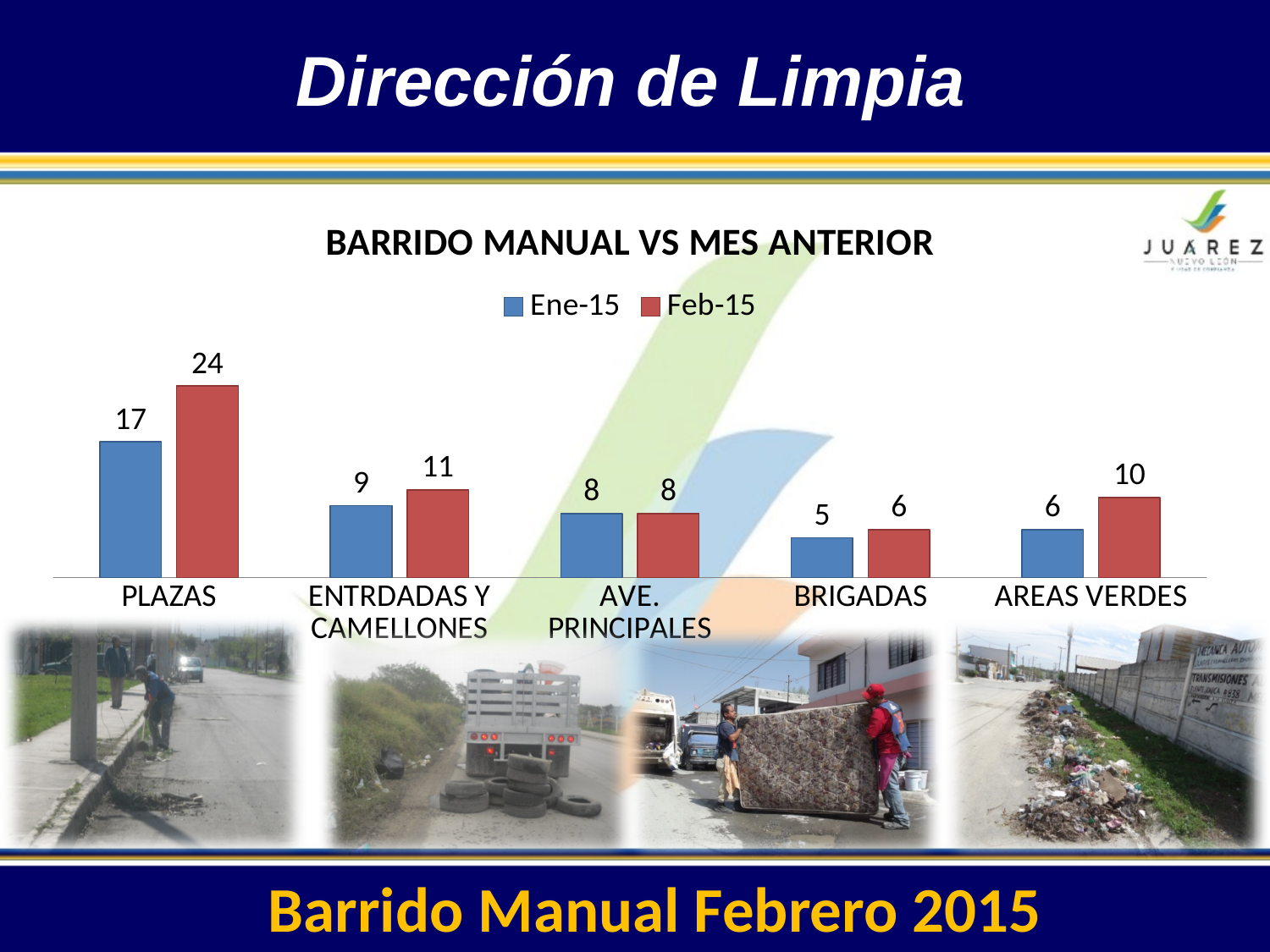
What is the difference between the Feb-15 and Ene-15 values for PLAZAS? 7 What kind of chart is shown? Bar chart Which category has the highest Feb-15 value? PLAZAS How many series does the legend list? 2 What is the Feb-15 value for PLAZAS? 24 Which is larger for AREAS VERDES, the Ene-15 value or the Feb-15 value? Feb-15 Which category has the lowest Ene-15 value? BRIGADAS What is the Feb-15 value for AREAS VERDES? 10 What is the Ene-15 value for ENTRDADAS Y CAMELLONES? 9 What is the title of the chart? BARRIDO MANUAL VS MES ANTERIOR How many categories are shown on the x axis? 5 Which colour represents the Feb-15 series? Red